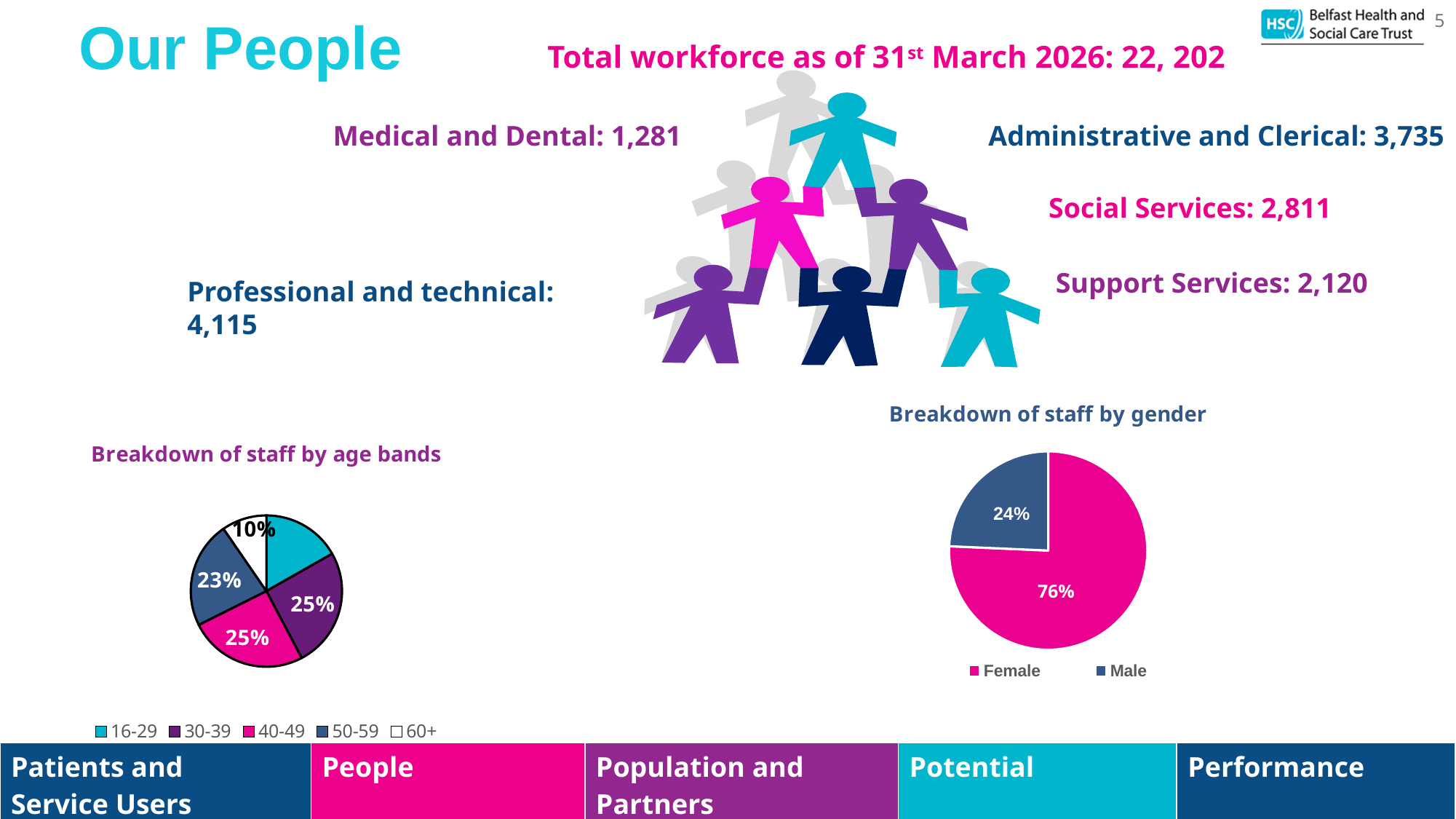
What type of chart is 'Breakdown of staff by gender'? Pie chart In the 'Breakdown of staff by age bands' pie chart, what percentage of staff are aged 60+? 10% How many categories does the legend of the 'Breakdown of staff by gender' chart list? 2 In the 'Breakdown of staff by age bands' pie chart, what percentage of staff are in the 30-39 age band? 25% In the 'Breakdown of staff by gender' pie chart, what percentage of staff are Male? 24% How many age bands does the legend of the 'Breakdown of staff by age bands' chart list? 5 In the 'Breakdown of staff by age bands' pie chart, what percentage of staff are in the 50-59 age band? 23% In the 'Breakdown of staff by age bands' pie chart, which age band has the smallest share? 60+ In the 'Breakdown of staff by gender' pie chart, which category has the largest share? Female In the 'Breakdown of staff by age bands' pie chart, which is larger: the 50-59 share or the 60+ share? 50-59 In the 'Breakdown of staff by gender' pie chart, what percentage of staff are Female? 76% In the 'Breakdown of staff by gender' pie chart, what is the difference in percentage points between the Female and Male shares? 52%